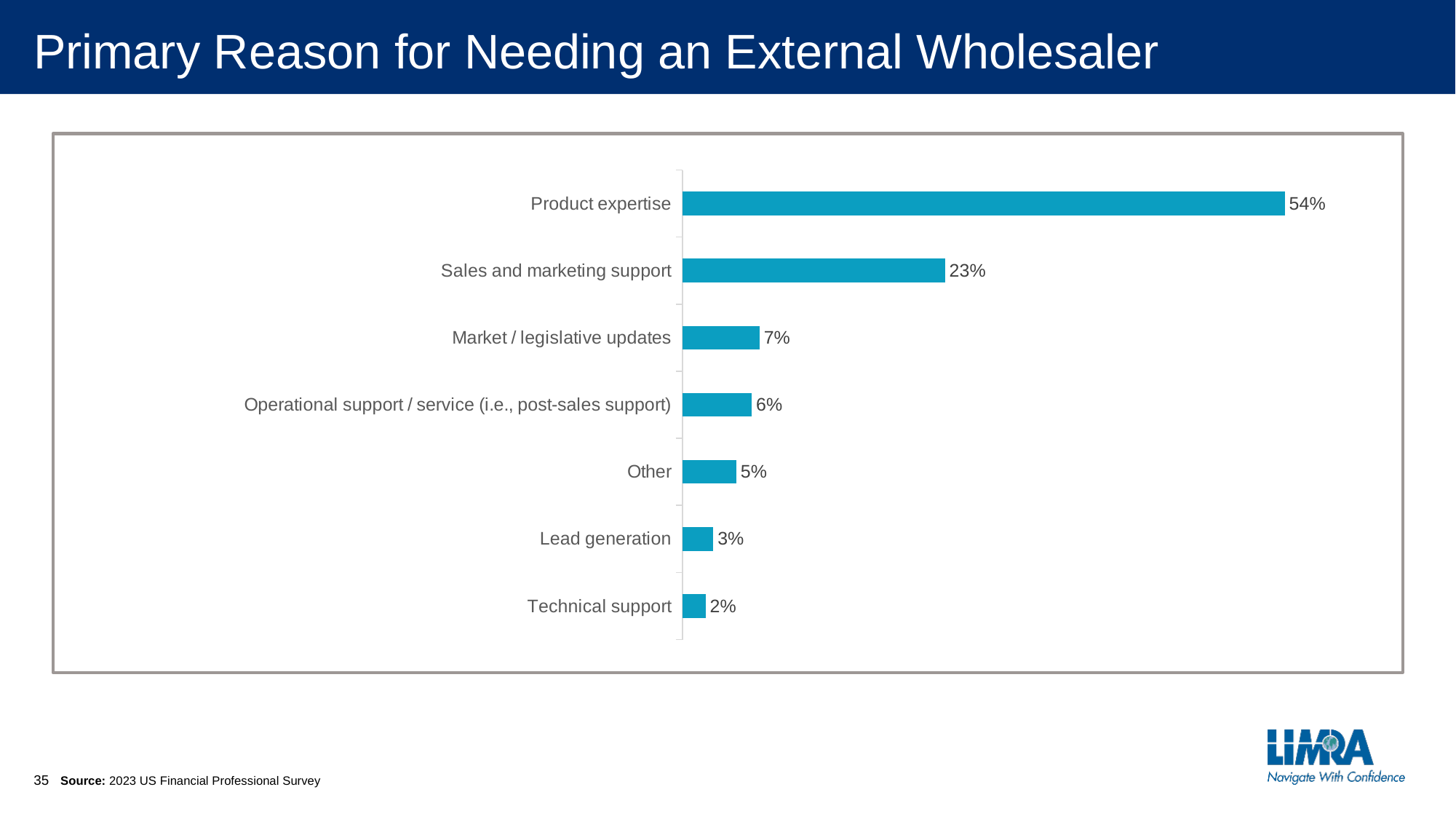
What is the value shown for Sales and marketing support? 23% What is the value for Lead generation? 3% Which reason has the lowest percentage? Technical support What is the difference in percentage points between Market / legislative updates and Other? 2 What is the source cited for the chart data? 2023 US Financial Professional Survey How many reasons (categories) are shown in the chart? 7 What percentage is shown for Operational support / service (i.e., post-sales support)? 6% Which reason has the highest percentage? Product expertise What is the difference in percentage points between Product expertise and Sales and marketing support? 31 What type of chart is shown on the slide? Bar chart What percentage of respondents cited Product expertise as the primary reason for needing an external wholesaler? 54% Which is larger: the value for Market / legislative updates or the value for Lead generation? Market / legislative updates